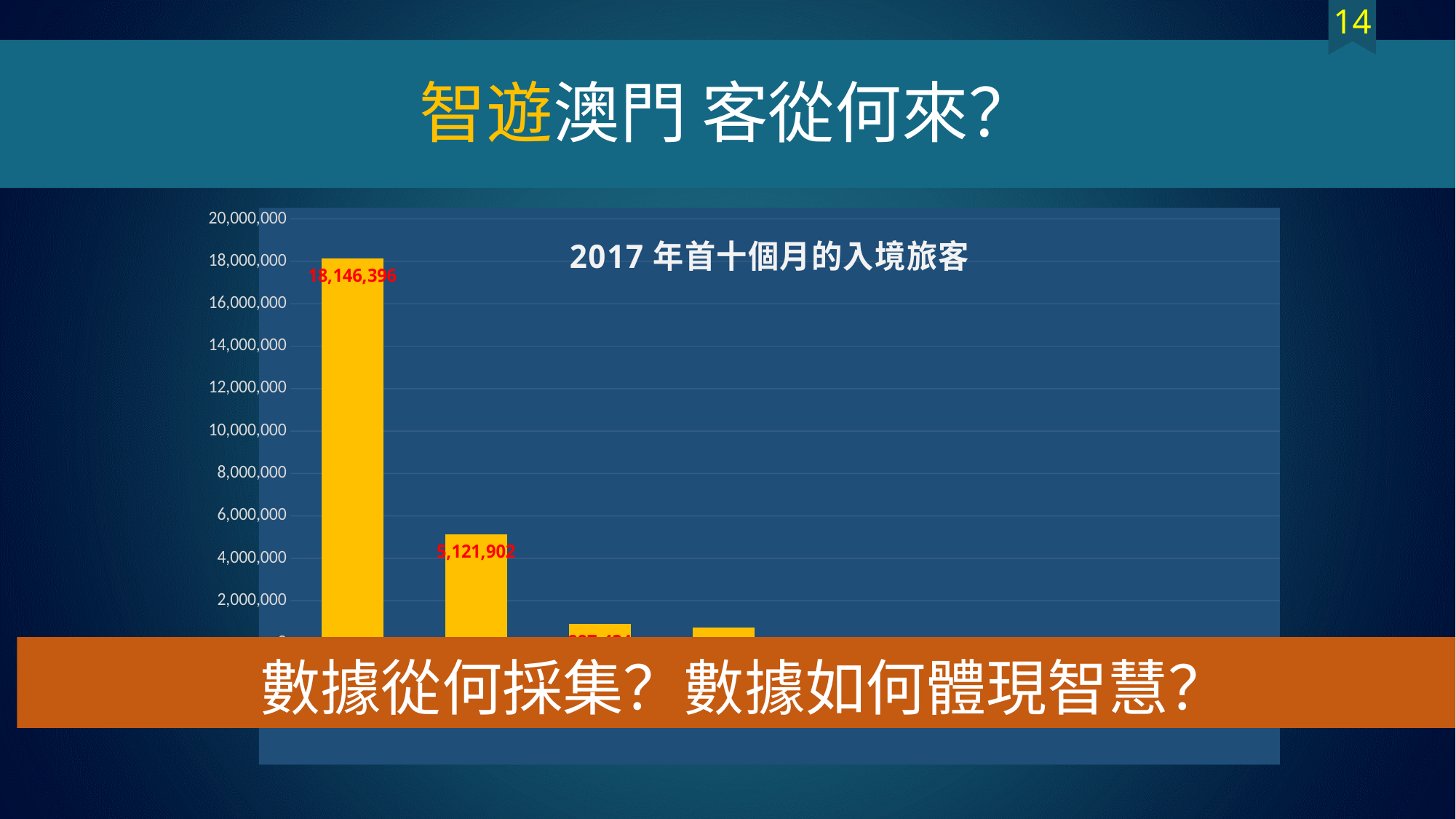
Is the value of the second bar greater or less than 4,000,000? greater What colour are the bars in the chart? yellow/orange Do the bar values rise or fall from left to right? fall Which is larger, the first bar or the second bar? the first bar What kind of chart is shown on the slide? bar chart What is the value labelled on the second bar from the left? 5,121,902 What is the difference between the first bar (18,146,396) and the second bar (5,121,902)? 13,024,494 What is the value labelled on the leftmost (first) bar? 18,146,396 Is the value of the third bar greater or less than 2,000,000? less Which bar has the highest value? the leftmost (first) bar What is the title of the chart? 2017 年首十個月的入境旅客